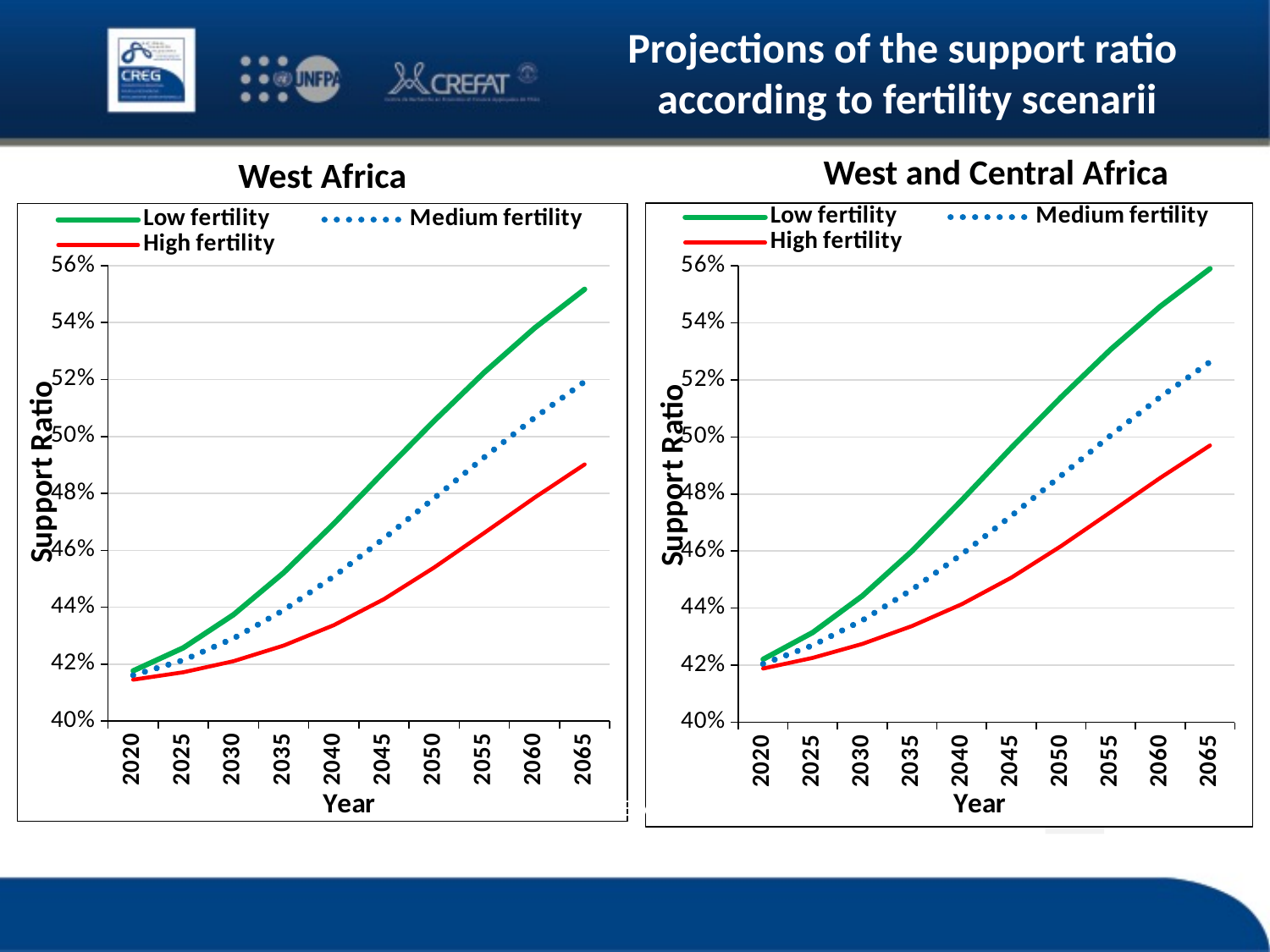
In the West Africa chart, is the High fertility value in 2065 greater or less than 50%? less What type of chart is the West Africa chart? Line chart What is the label of the y axis on the West Africa chart? Support Ratio How many series does the legend of the West and Central Africa chart list? 3 In the West and Central Africa chart, which is larger in 2050: the Low fertility value or the High fertility value? Low fertility How many year ticks are shown on the x axis of the West Africa chart? 10 In the West Africa chart, does the Low fertility series rise or fall from 2020 to 2065? Rise In the West and Central Africa chart, which series has the lowest value in 2065? High fertility In the West Africa chart, which series has the highest value in 2065? Low fertility In the West and Central Africa chart, is the Medium fertility value in 2065 greater or less than 50%? greater In the West Africa chart, is the Low fertility value in 2065 greater or less than 54%? greater In the West and Central Africa chart, does the High fertility series rise or fall over the years shown? Rise